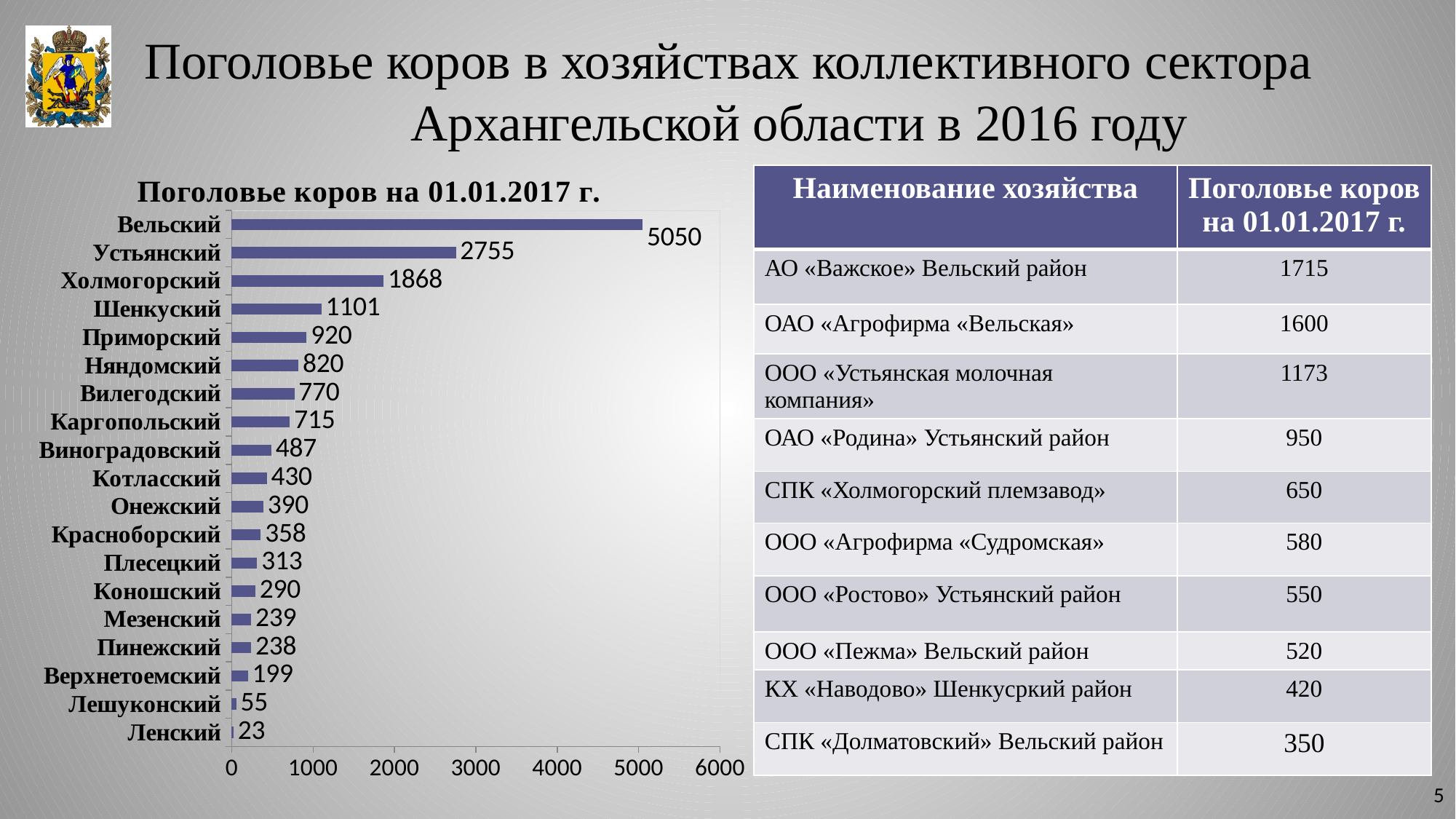
What is the title of the chart? Поголовье коров на 01.01.2017 г. How many districts are shown in the chart? 19 Which is larger, the value for Няндомский or the value for Вилегодский? Няндомский Which district has the lowest number of cows in the chart? Ленский What is the difference between the values for Холмогорский and Шенкуский? 767 What kind of chart is shown on the slide? bar chart What is the value for Вельский in the chart? 5050 What is the difference between the values for Вельский and Устьянский? 2295 Which district has the highest number of cows in the chart? Вельский Is the value for Устьянский greater or less than 3000? less What is the value for Верхнетоемский in the chart? 199 What is the value for Приморский in the chart? 920